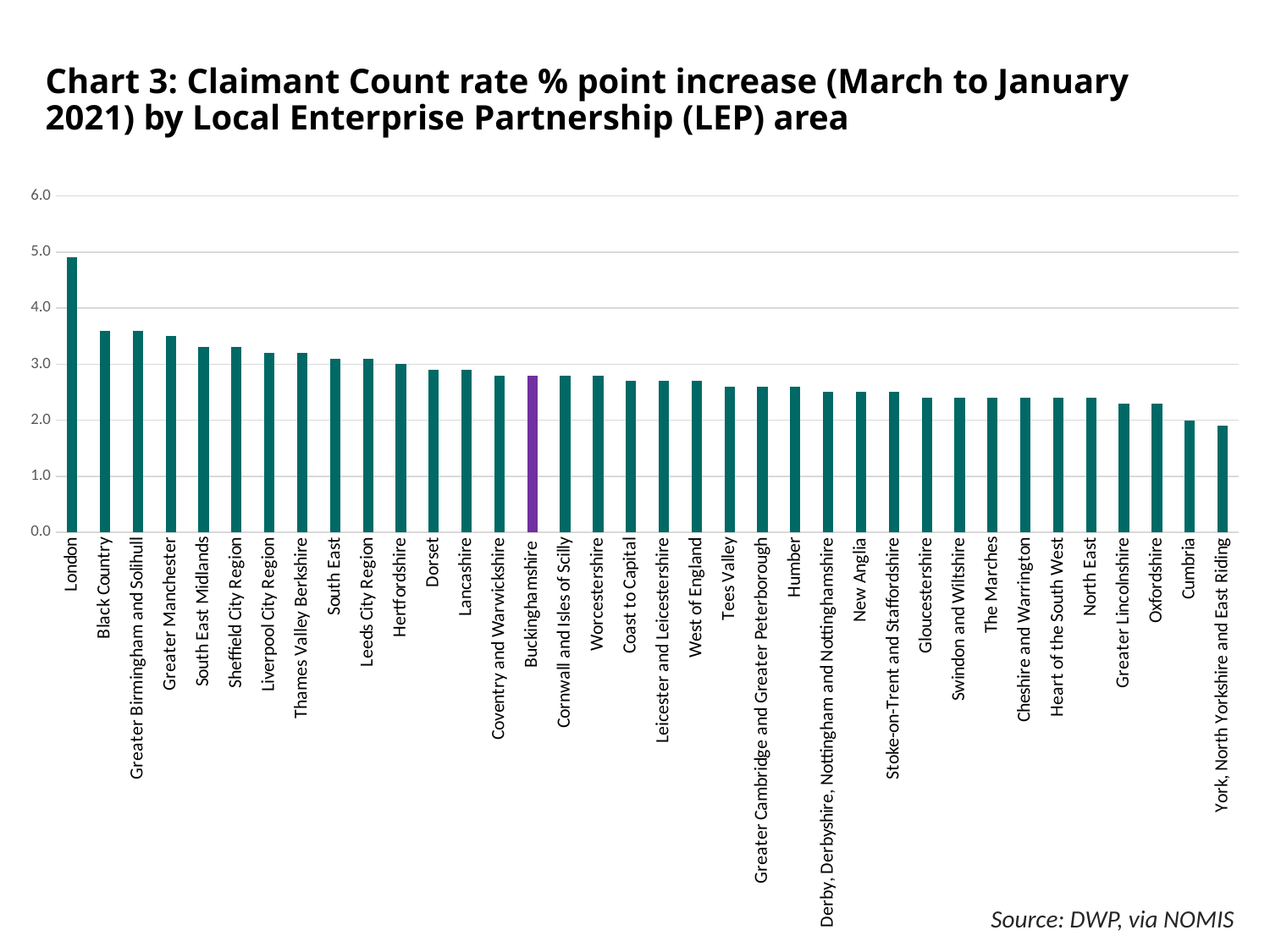
Which has the larger value, London or Black Country? London Do the values rise or fall moving from left to right along the x axis? Fall Is the value for Buckinghamshire greater or less than 3.0? less Which LEP area has the lowest Claimant Count rate % point increase? York, North Yorkshire and East Riding Which LEP area has the highest Claimant Count rate % point increase? London Which has the larger value, Greater Manchester or Cumbria? Greater Manchester What kind of chart is shown on the slide? Bar chart Is the value for Black Country greater or less than 3.0? greater Which LEP area's bar is highlighted in purple rather than green? Buckinghamshire Is the value for London greater or less than 4.0? greater